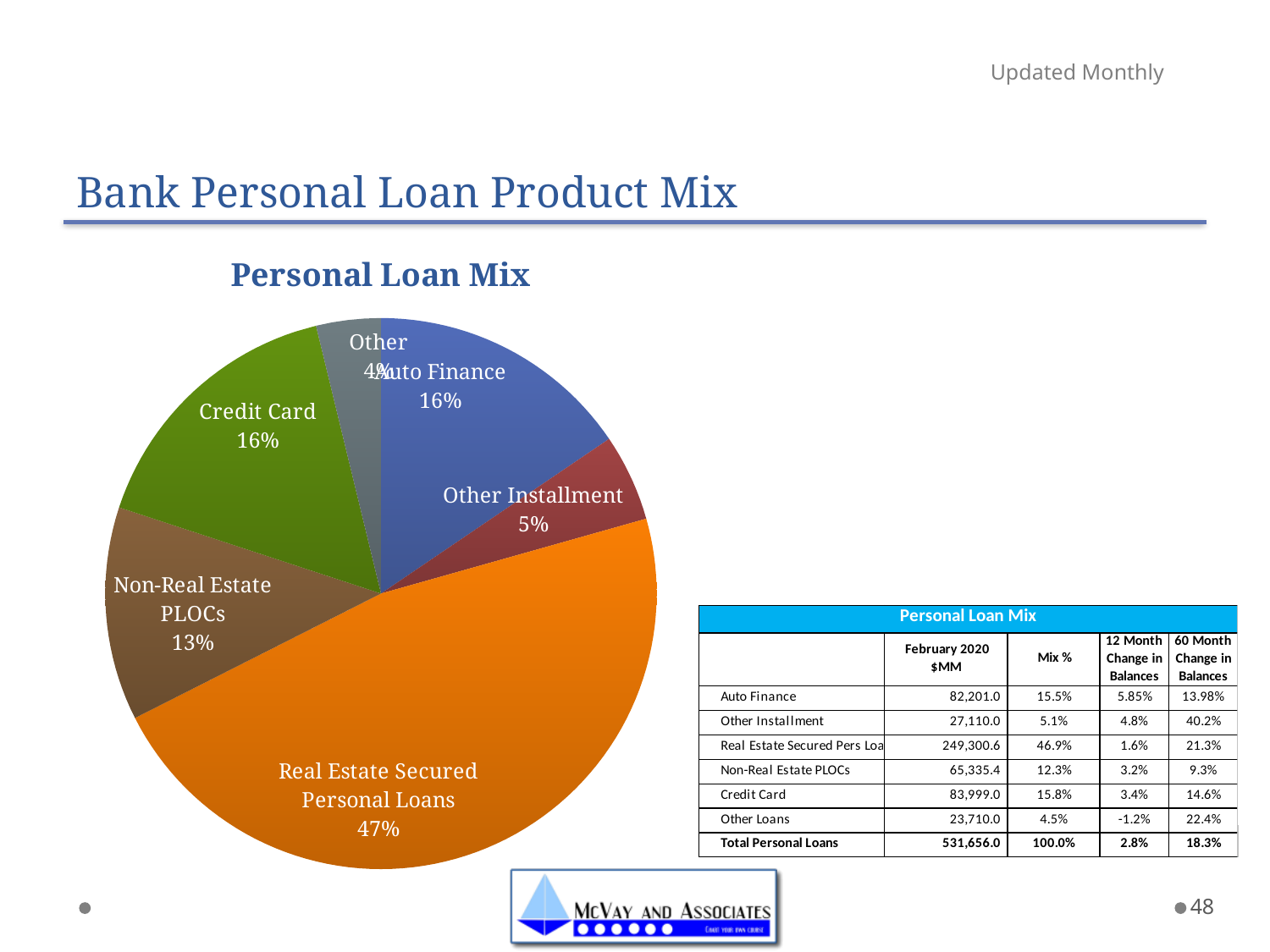
Which slice is larger, Non-Real Estate PLOCs or Other Installment? Non-Real Estate PLOCs What percentage does the Non-Real Estate PLOCs slice show? 13% Which slice of the pie chart is the largest? Real Estate Secured Personal Loans How many slices does the pie chart have? 6 What is the chart type of the Personal Loan Mix chart? pie chart What percentage does the Auto Finance slice show? 16% What is the difference in percentage points between Real Estate Secured Personal Loans and Non-Real Estate PLOCs? 34% What percentage does the Credit Card slice show? 16% What share of the pie is Real Estate Secured Personal Loans? 47% Which slice is larger, Credit Card or Other Installment? Credit Card What is the title of the pie chart? Personal Loan Mix What percentage does the Other Installment slice show? 5%